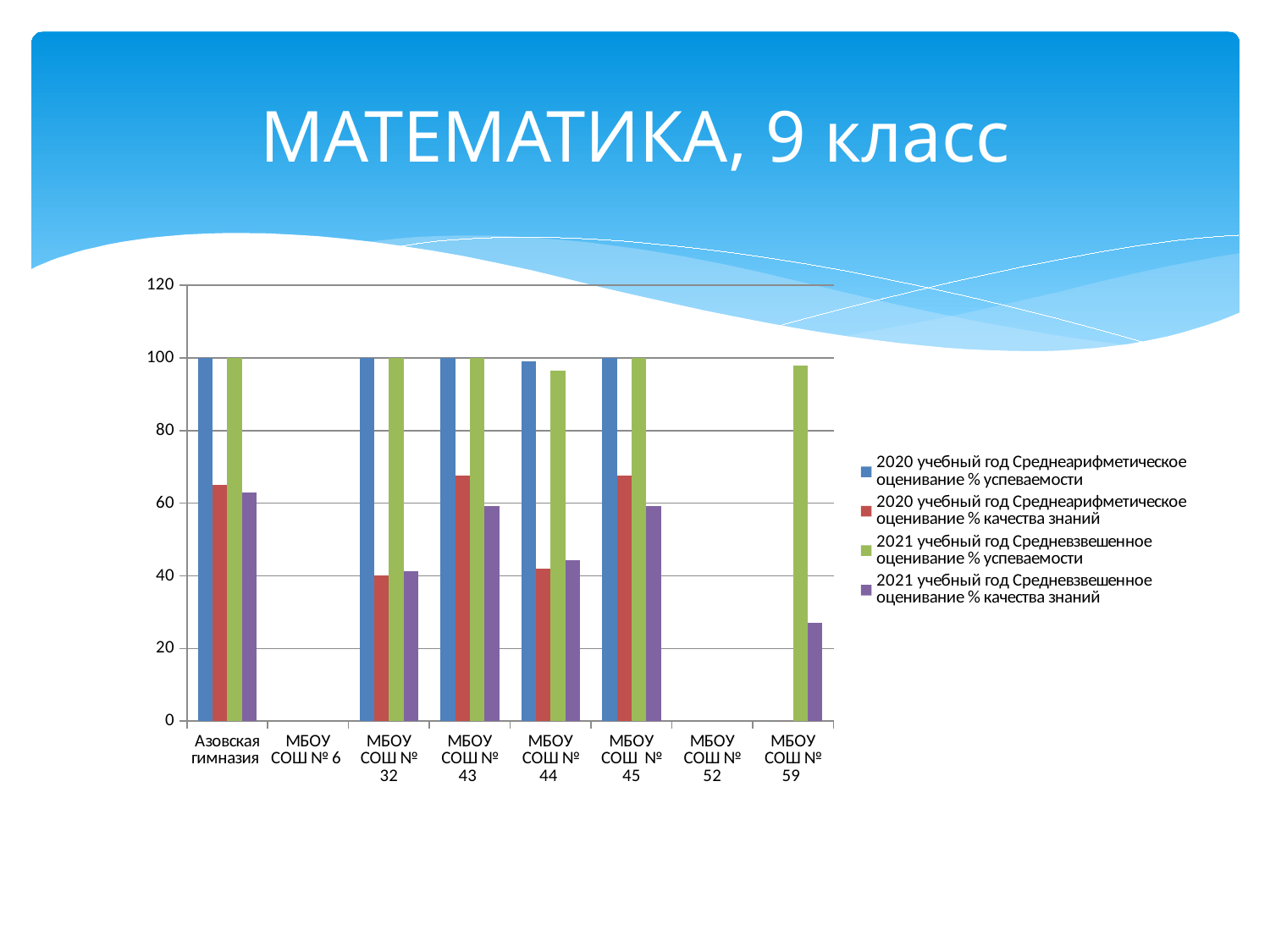
What is the value of '2021 учебный год Средневзвешенное оценивание % успеваемости' for МБОУ СОШ № 43? 100 How many series does the legend list? 4 Which series is shown in green? 2021 учебный год Средневзвешенное оценивание % успеваемости Which has the larger value for '2021 учебный год Средневзвешенное оценивание % качества знаний': МБОУ СОШ № 43 or МБОУ СОШ № 59? МБОУ СОШ № 43 What kind of chart is shown on the slide? bar chart How many school categories are shown on the x axis? 8 Is the value of '2021 учебный год Средневзвешенное оценивание % качества знаний' for МБОУ СОШ № 59 greater or less than 40? less Which has the larger value for '2020 учебный год Среднеарифметическое оценивание % качества знаний': Азовская гимназия or МБОУ СОШ № 32? Азовская гимназия What is the title of the slide? МАТЕМАТИКА, 9 класс What is the value of '2020 учебный год Среднеарифметическое оценивание % успеваемости' for Азовская гимназия? 100 Is the value of '2020 учебный год Среднеарифметическое оценивание % качества знаний' for Азовская гимназия greater or less than 60? greater Is the value of '2020 учебный год Среднеарифметическое оценивание % качества знаний' for МБОУ СОШ № 32 greater or less than 60? less